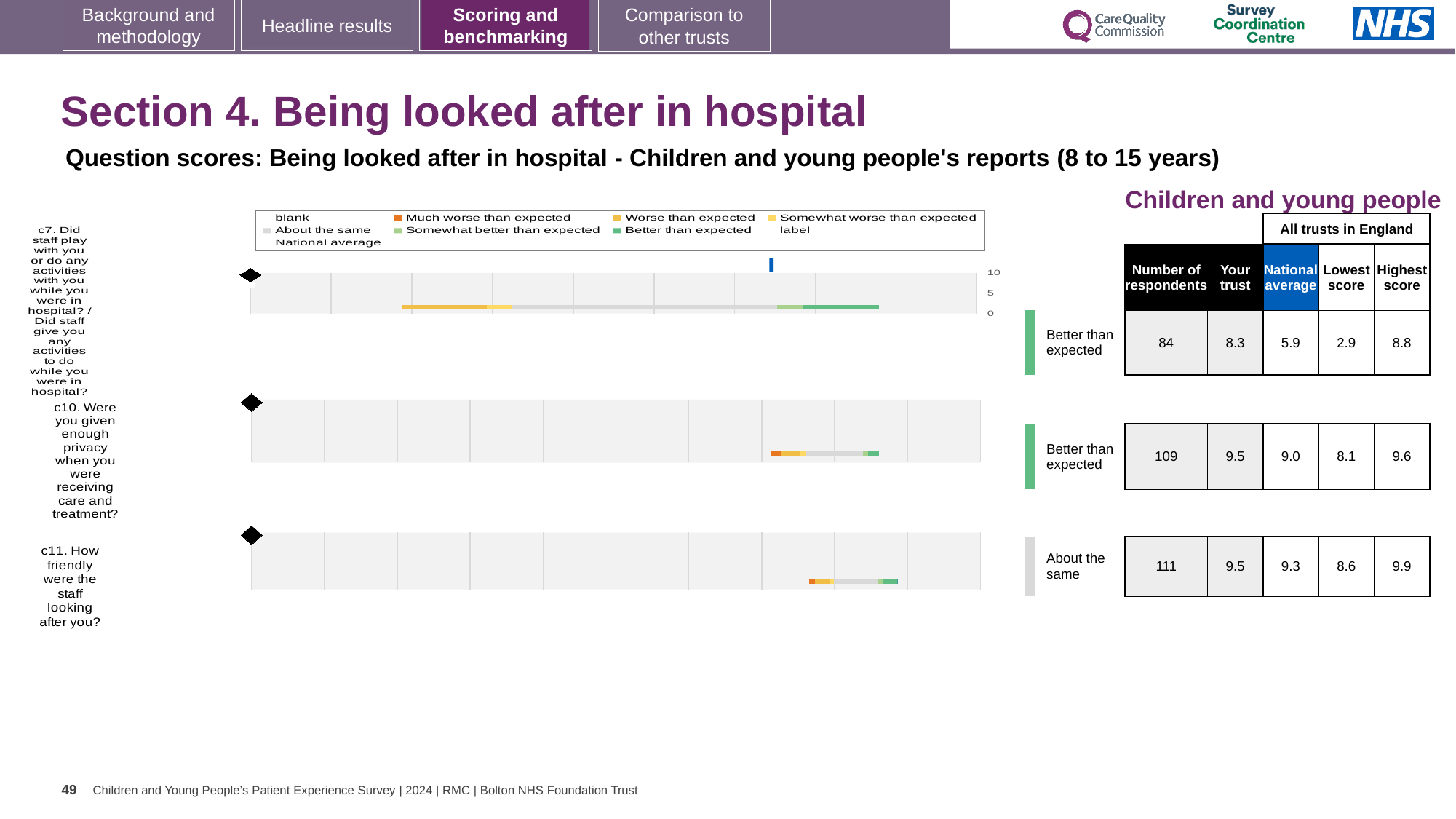
What is the national average score for question c7 (Did staff play with you or do any activities with you while you were in hospital?)? 5.9 Which question has the most respondents? c11 What is the 'Your trust' score for question c10 (Were you given enough privacy when you were receiving care and treatment?)? 9.5 How many survey questions are charted on the slide? 3 What is the highest score across all trusts in England for question c10? 9.6 How many respondents answered question c11 (How friendly were the staff looking after you?)? 111 What benchmark category is shown for question c11 (How friendly were the staff looking after you?)? About the same What kind of chart is used for each question on the slide? bar chart Which question has the lowest 'Your trust' score? c7 For question c11, which is larger: the 'Your trust' score or the national average? Your trust What is the lowest score across all trusts in England for question c7? 2.9 What is the difference between the 'Your trust' score and the national average for question c7? 2.4